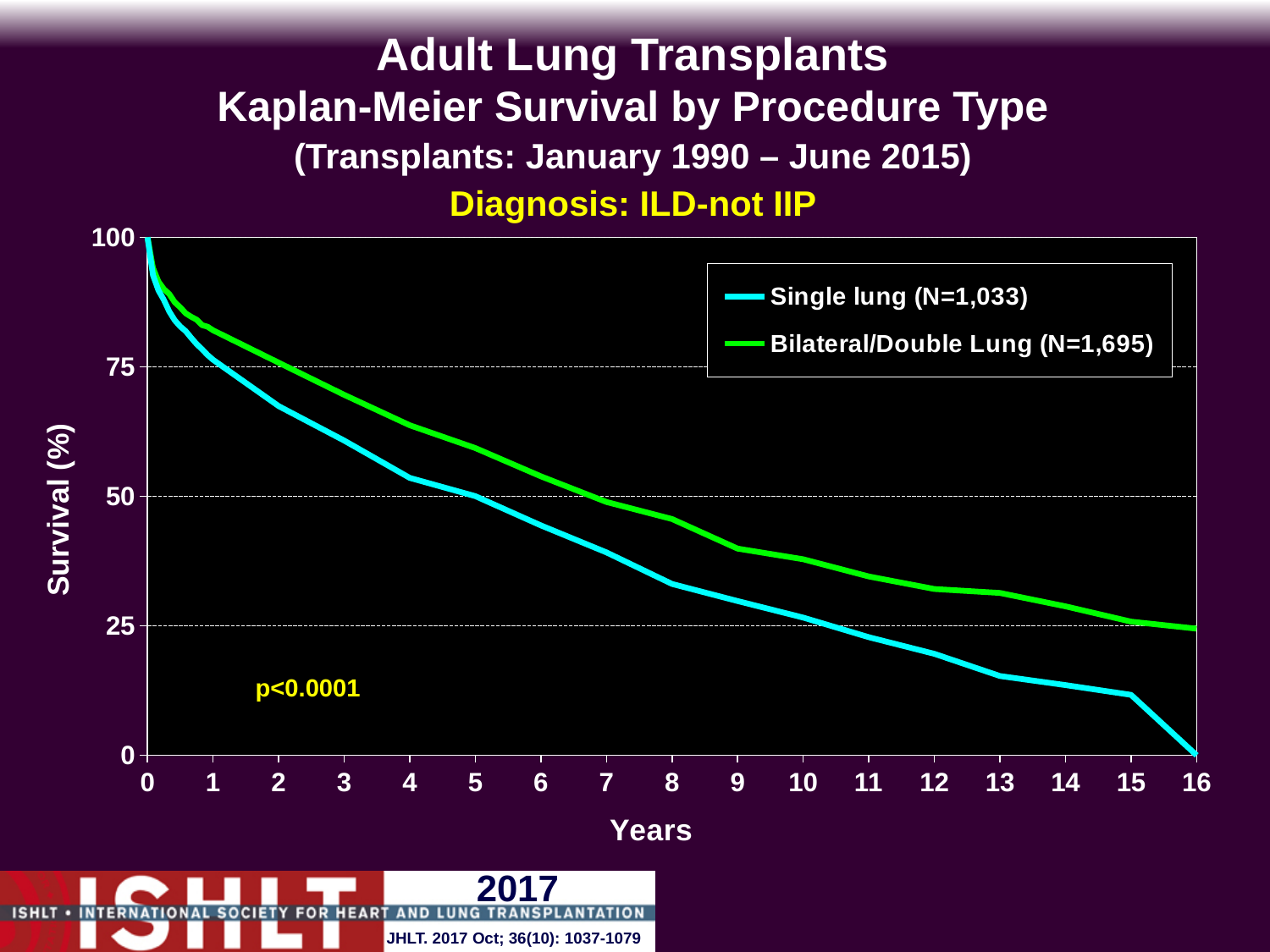
Is the survival for Single lung at year 8 greater or less than 25? greater Is the survival for Single lung at year 12 greater or less than 25? less Is the survival for Single lung at year 2 greater or less than 75? less What kind of chart is shown on the slide? line chart What p-value is printed on the chart? p<0.0001 How many series does the legend list? 2 Do the survival curves rise or fall as years increase? fall What is the number of patients (N) in the Single lung group according to the legend? 1,033 At year 8, which series has the higher survival, Single lung or Bilateral/Double Lung? Bilateral/Double Lung